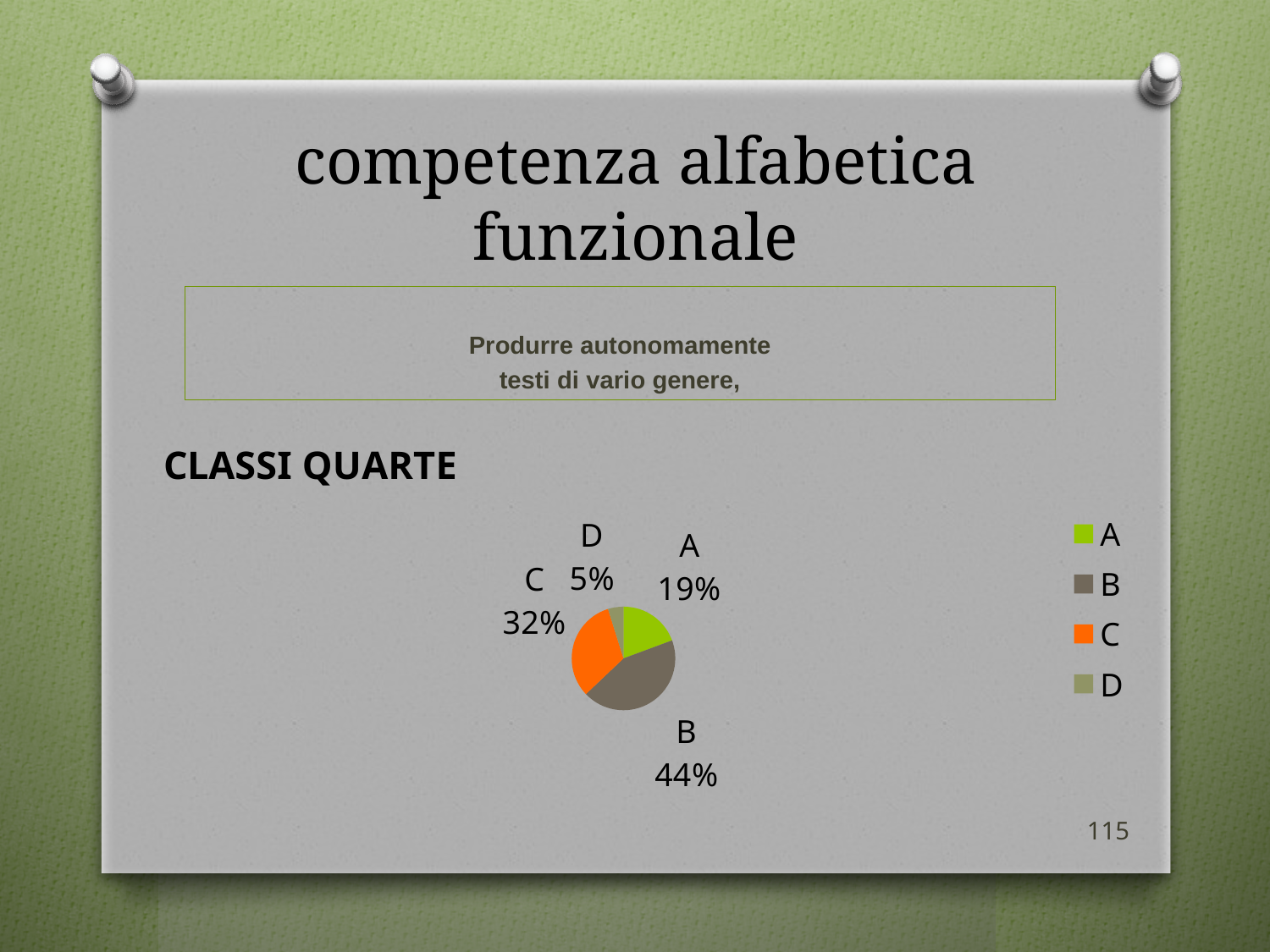
What is the value shown for category D in the pie chart? 5% What share of the pie chart does category B represent? 44% What is the value shown for category A in the pie chart? 19% Which is larger in the pie chart, category A or category C? C Which category has the largest slice in the pie chart? B What colour is the slice for category C in the pie chart? orange How many categories are shown in the pie chart? 4 What is the difference in percentage points between category A and category D? 14 What kind of chart is shown on the slide? pie chart Which category has the smallest slice in the pie chart? D What is the difference in percentage points between category B and category C? 12 What is the value shown for category C in the pie chart? 32%